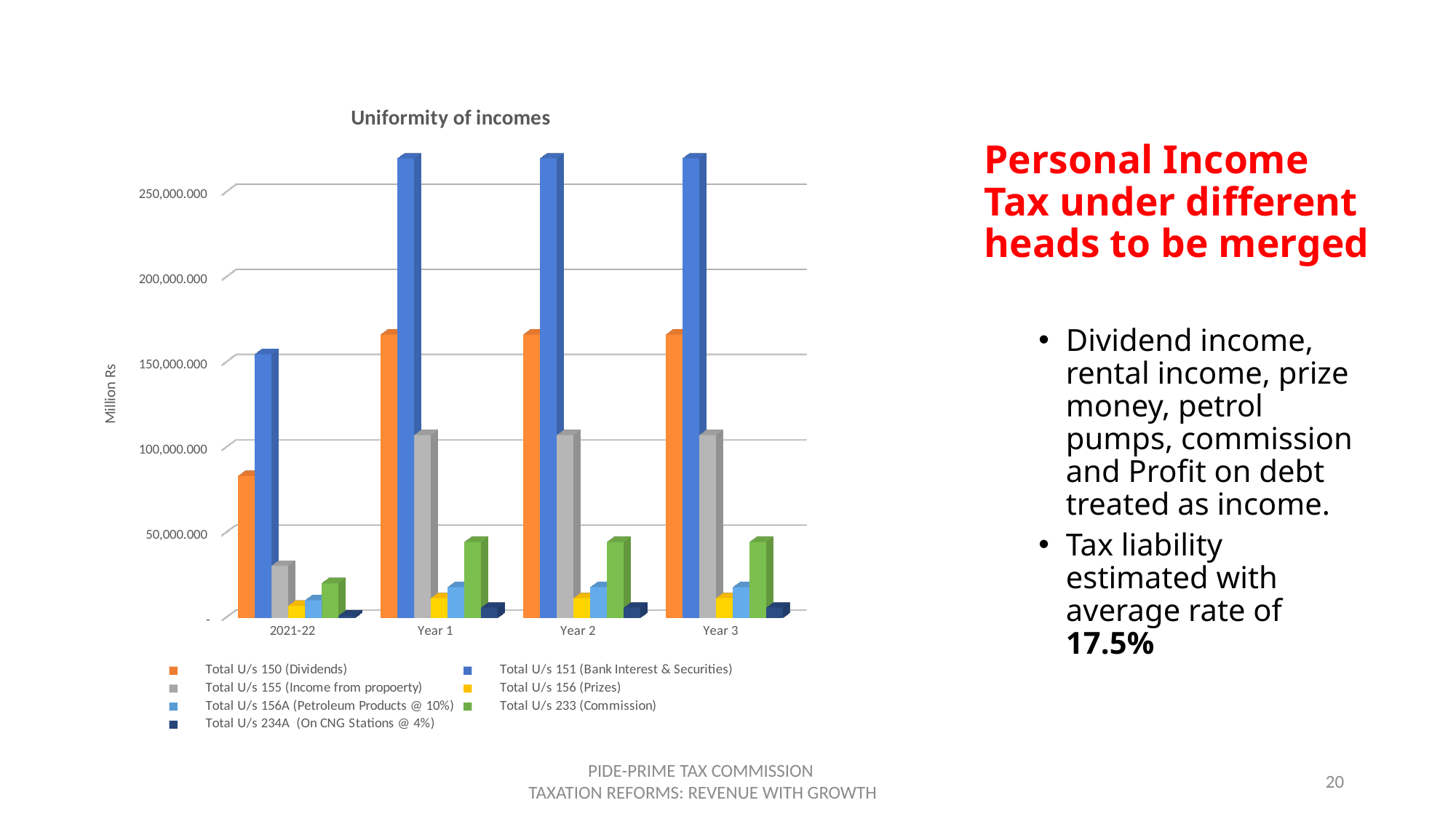
How many series does the chart's legend list? 7 In Year 3, which is larger: Total U/s 150 (Dividends) or Total U/s 155 (Income from propoerty)? Total U/s 150 (Dividends) Which series has the highest value in 2021-22? Total U/s 151 (Bank Interest & Securities) Which series has the lowest value in Year 1? Total U/s 234A (On CNG Stations @ 4%) What type of chart is shown on the slide? bar chart Does the value for Total U/s 151 (Bank Interest & Securities) rise or fall from 2021-22 to Year 1? rise Is the value for Total U/s 150 (Dividends) in Year 3 greater or less than 150,000.000? greater Is the value for Total U/s 150 (Dividends) in 2021-22 greater or less than 100,000.000? less Is the value for Total U/s 151 (Bank Interest & Securities) in Year 2 greater or less than 250,000.000? greater How many categories are shown on the x axis of the chart? 4 What is the label of the vertical axis? Million Rs What is the title of the chart? Uniformity of incomes